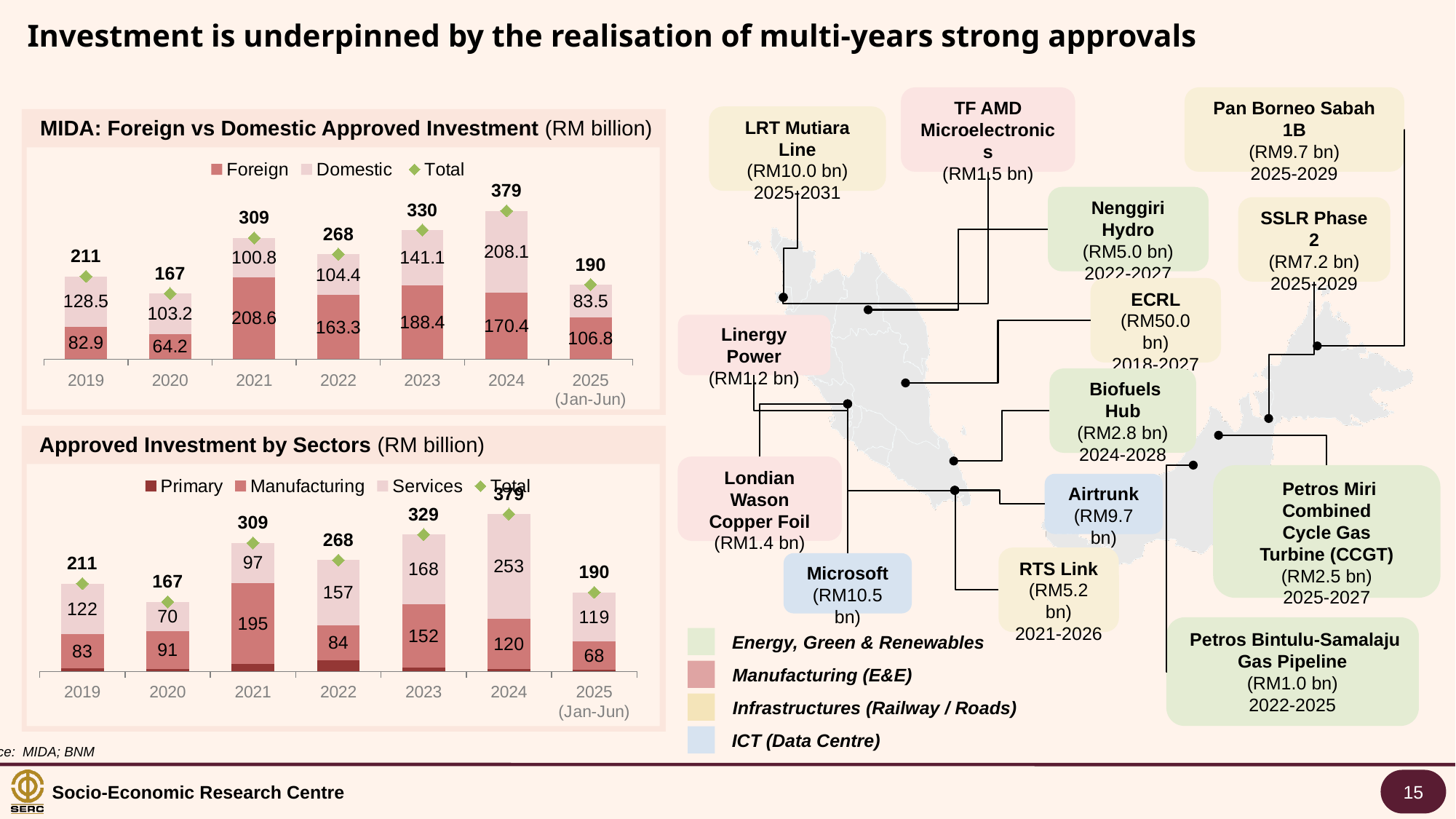
In the 'Approved Investment by Sectors' chart, what is the Services value for 2024? 253 In the 'Approved Investment by Sectors' chart, what is the Manufacturing value for 2021? 195 In the 'MIDA: Foreign vs Domestic Approved Investment' chart, is the Foreign or Domestic value larger in 2019? Domestic How many series does the legend of the 'MIDA: Foreign vs Domestic Approved Investment' chart list? 3 In the 'MIDA: Foreign vs Domestic Approved Investment' chart, what is the Foreign value for 2021? 208.6 In the 'MIDA: Foreign vs Domestic Approved Investment' chart, what is the difference between the Foreign and Domestic values for 2023? 47.3 In the 'MIDA: Foreign vs Domestic Approved Investment' chart, what is the Domestic value for 2024? 208.1 In the 'MIDA: Foreign vs Domestic Approved Investment' chart, which year has the highest Total? 2024 In the 'Approved Investment by Sectors' chart, which year has the lowest Manufacturing value? 2025 (Jan-Jun) What kind of chart is the 'Approved Investment by Sectors' chart? Stacked bar chart In the 'MIDA: Foreign vs Domestic Approved Investment' chart, which year has the lowest Foreign value? 2020 How many categories are shown on the x axis of the 'Approved Investment by Sectors' chart? 7